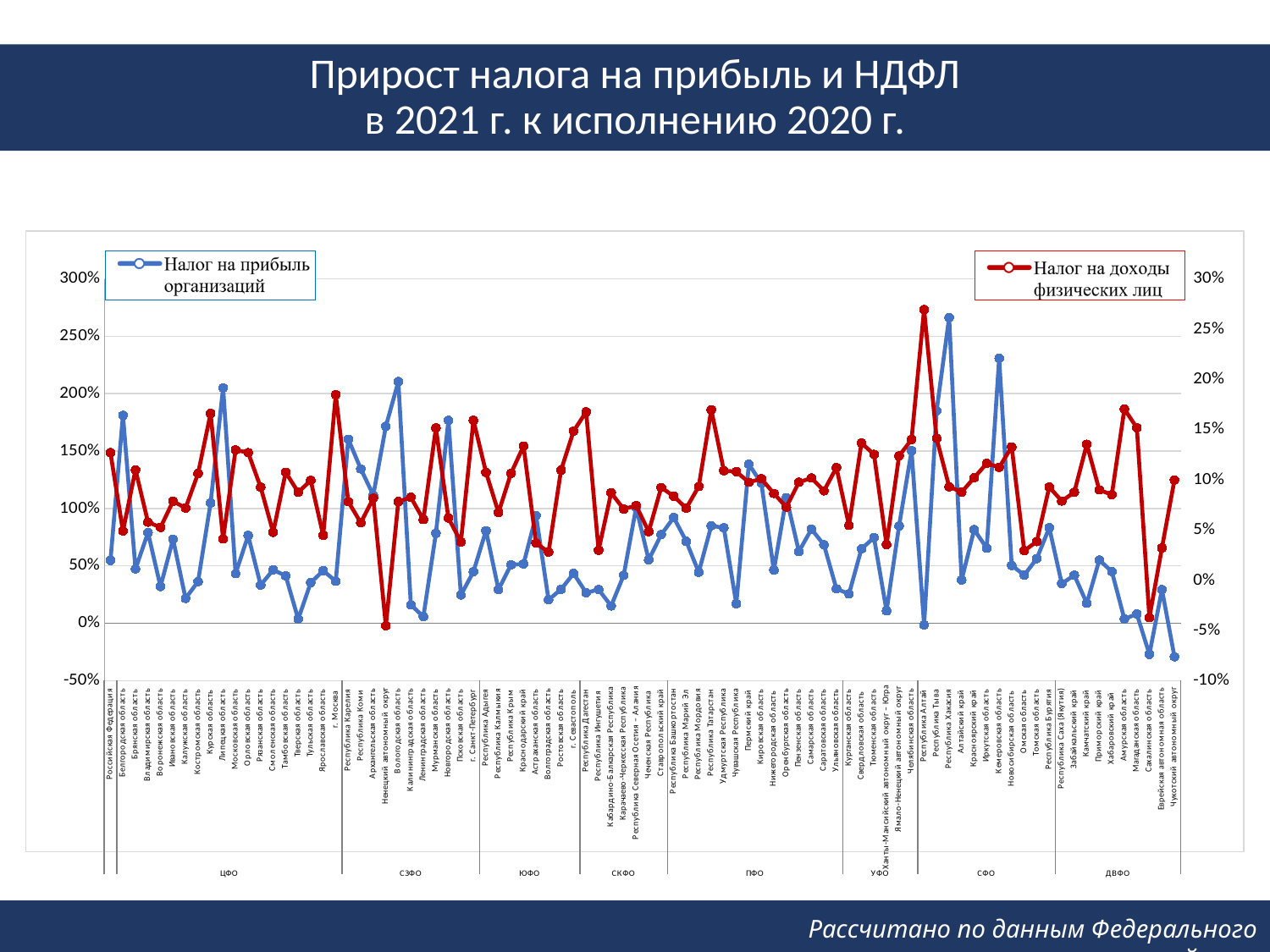
Which region has the highest value for 'Налог на доходы физических лиц'? Республика Алтай Which has the larger value for 'Налог на доходы физических лиц': Республика Алтай or Республика Тыва? Республика Алтай Which has the larger value for 'Налог на прибыль организаций': Республика Хакасия or Вологодская область? Республика Хакасия How many series does the chart's legend list? 2 What is the title of the chart on the slide? Прирост налога на прибыль и НДФЛ в 2021 г. к исполнению 2020 г. What kind of chart is shown on the slide? line chart Is the value of 'Налог на прибыль организаций' for Республика Хакасия greater or less than 250%? greater Is the value of 'Налог на доходы физических лиц' for Республика Алтай greater or less than 25%? greater Which colour is used for the series 'Налог на доходы физических лиц'? red Is the value of 'Налог на прибыль организаций' for Чукотский автономный округ greater or less than 0%? less Which region has the highest value for 'Налог на прибыль организаций'? Республика Хакасия